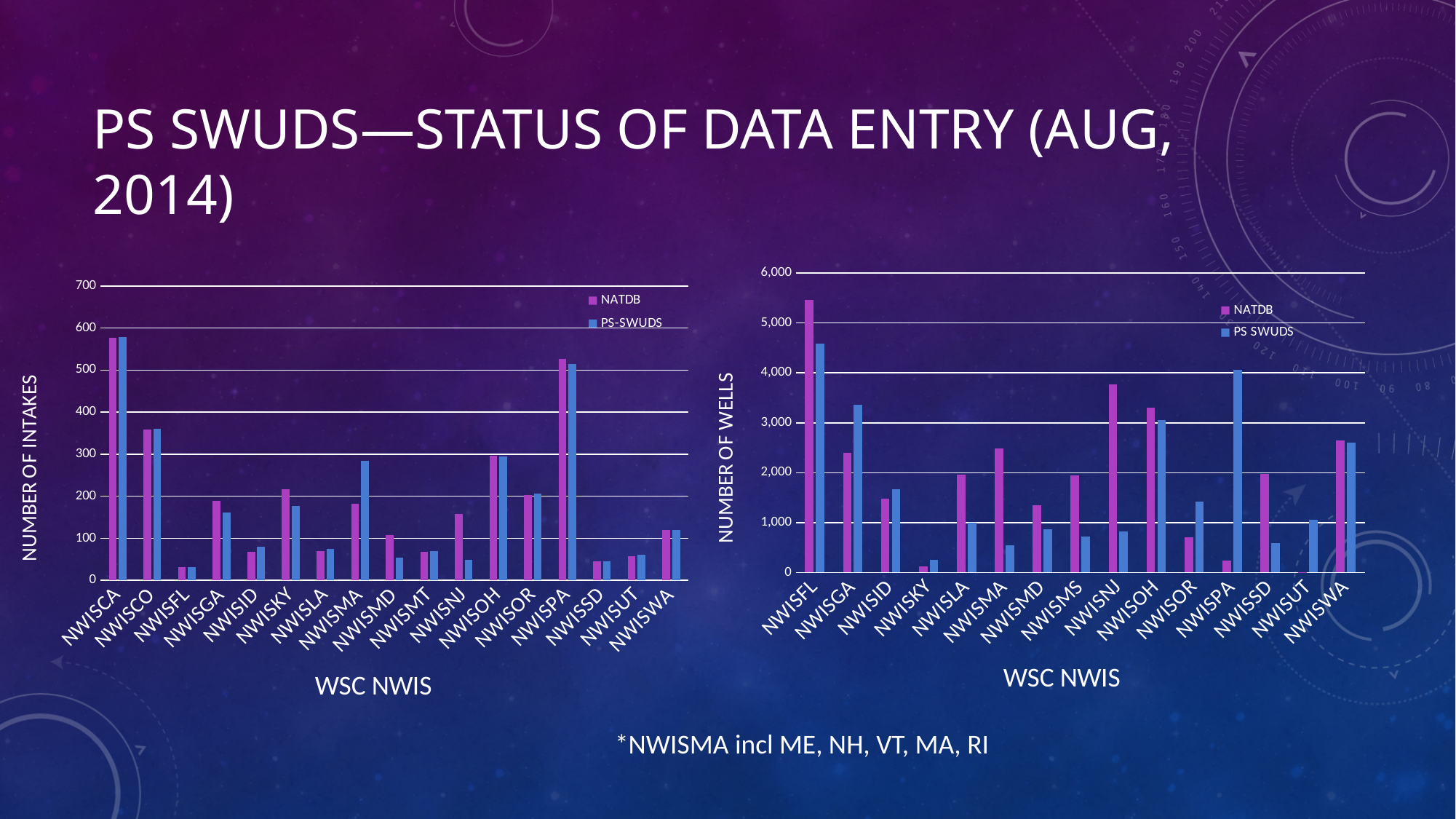
How many series does the legend of the right chart (Number of Wells) list? 2 In the right chart (Number of Wells), is the NATDB value for NWISNJ greater or less than 3,000? greater What kind of chart is the left chart (Number of Intakes)? bar chart In the right chart (Number of Wells), which category has the highest NATDB value? NWISFL In the right chart (Number of Wells), which category has the lowest NATDB value? NWISUT How many WSC NWIS categories are shown on the x axis of the left chart (Number of Intakes)? 17 In the right chart (Number of Wells), for NWISPA, which series has the larger value, NATDB or PS SWUDS? PS SWUDS In the left chart (Number of Intakes), is the NATDB value for NWISCA greater or less than 500? greater How many WSC NWIS categories are shown on the x axis of the right chart (Number of Wells)? 15 What is the x-axis title of the left chart (Number of Intakes)? WSC NWIS In the left chart (Number of Intakes), which category has the highest NATDB value? NWISCA In the right chart (Number of Wells), is the NATDB value for NWISKY greater or less than 1,000? less